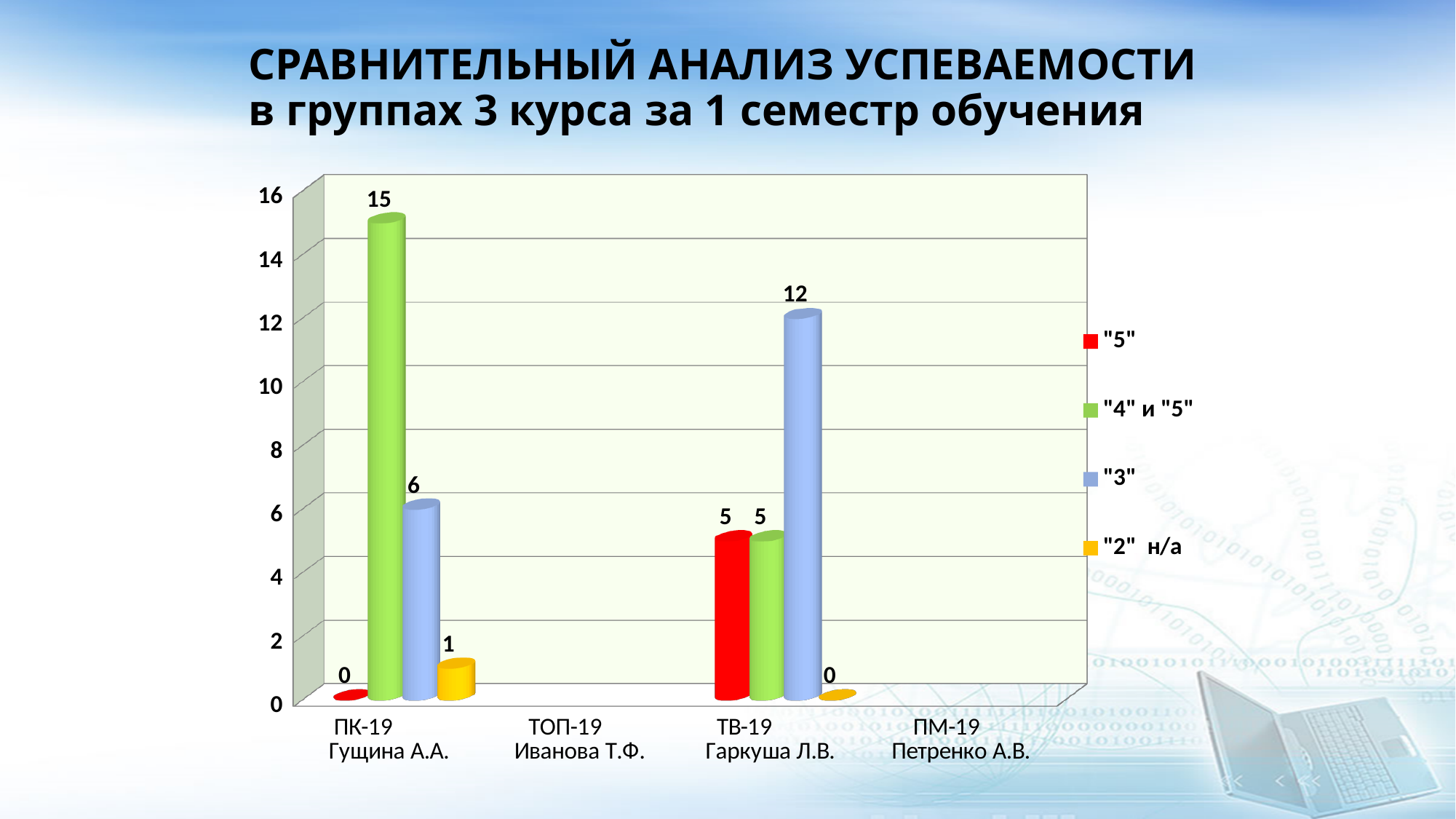
What is the difference between the "3" values for ТВ-19 Гаркуша Л.В. and ПК-19 Гущина А.А.? 6 What is the value of the "3" series for ТВ-19 Гаркуша Л.В.? 12 What is the value of the "5" series for ПК-19 Гущина А.А.? 0 What type of chart is shown on the slide? Bar chart Which series has the highest value for ТВ-19 Гаркуша Л.В.? "3" What is the value of the "5" series for ТВ-19 Гаркуша Л.В.? 5 What is the value of the "4" и "5" series for ПК-19 Гущина А.А.? 15 What is the value of the "2" н/а series for ПК-19 Гущина А.А.? 1 Which series has the highest value for ПК-19 Гущина А.А.? "4" и "5" How many series does the legend list? 4 Which is larger: the "4" и "5" value for ПК-19 Гущина А.А. or for ТВ-19 Гаркуша Л.В.? ПК-19 Гущина А.А. How many categories are shown on the x axis? 4